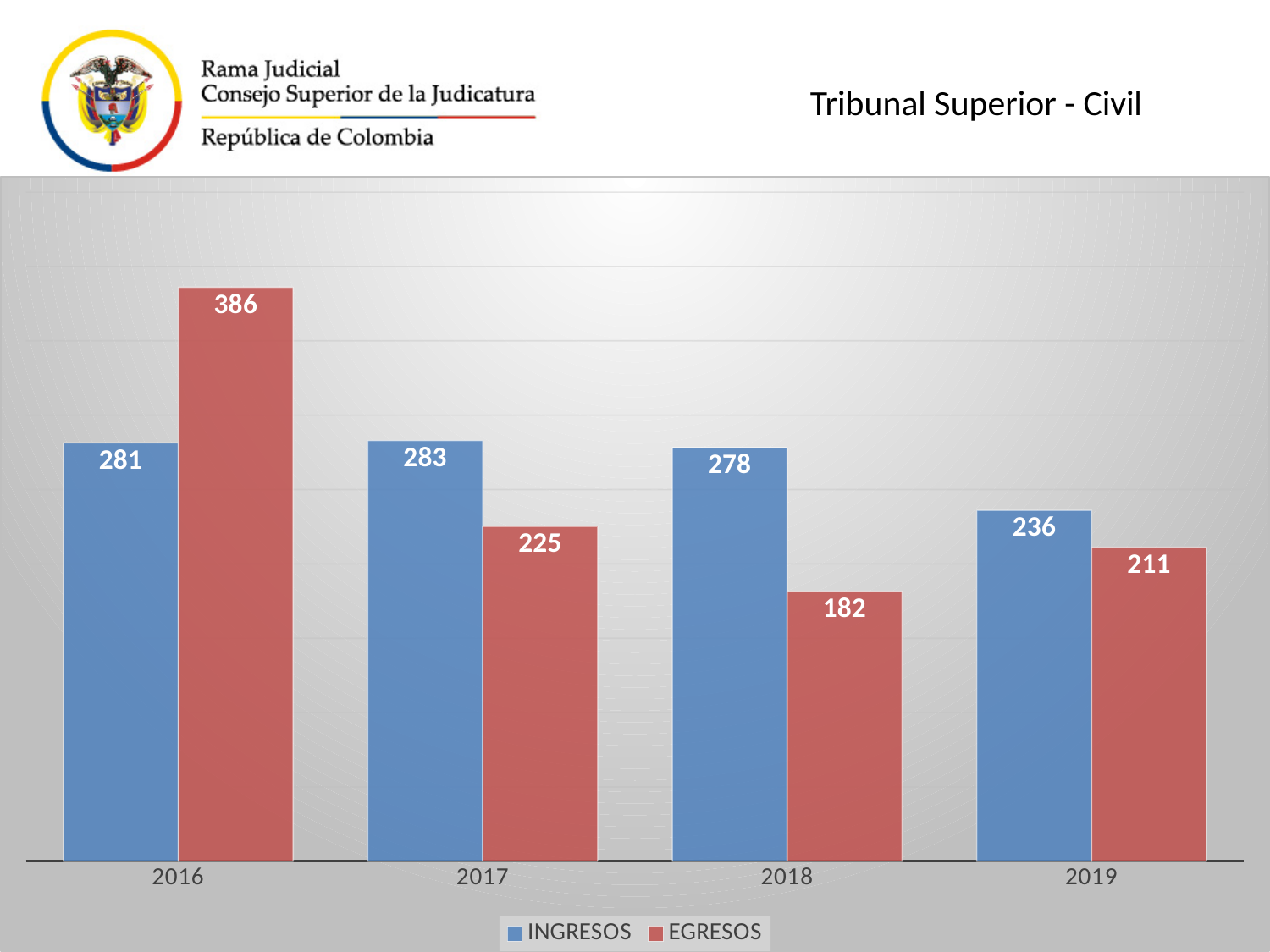
What is the EGRESOS value for 2019? 211 Which colour represents EGRESOS in the chart? red Which year has the lowest INGRESOS value? 2019 What is the EGRESOS value for 2018? 182 How many series does the legend list? 2 What kind of chart is shown on the slide? bar chart How many years are shown on the x axis? 4 What is the difference between INGRESOS and EGRESOS in 2018? 96 What is the difference between EGRESOS and INGRESOS in 2016? 105 What is the INGRESOS value for 2016? 281 In 2017, which is larger, INGRESOS or EGRESOS? INGRESOS Which year has the highest EGRESOS value? 2016